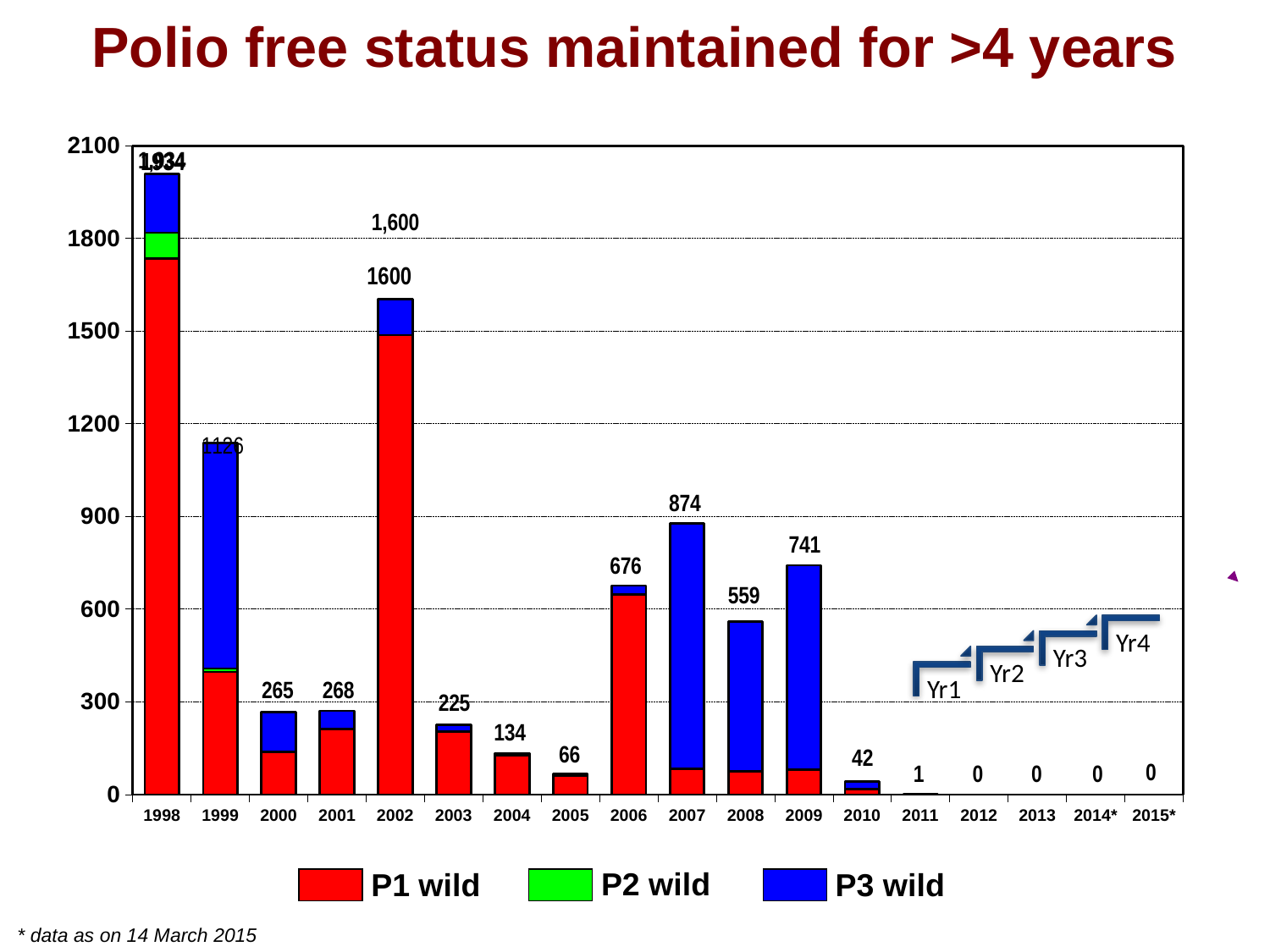
How many series does the legend list? 3 What is the total number of cases shown for 2007? 874 What is the total number of cases shown for 2010? 42 What is the difference between the totals for 2007 and 2008? 315 Which year has the larger total, 2006 or 2009? 2009 What is the total number of cases shown for 2011? 1 Which year has the tallest bar? 1998 What kind of chart is shown on the slide? stacked bar chart How many years are shown on the x axis? 18 Is the total for 2005 greater or less than 300? less What is the total number of cases shown for 2002? 1600